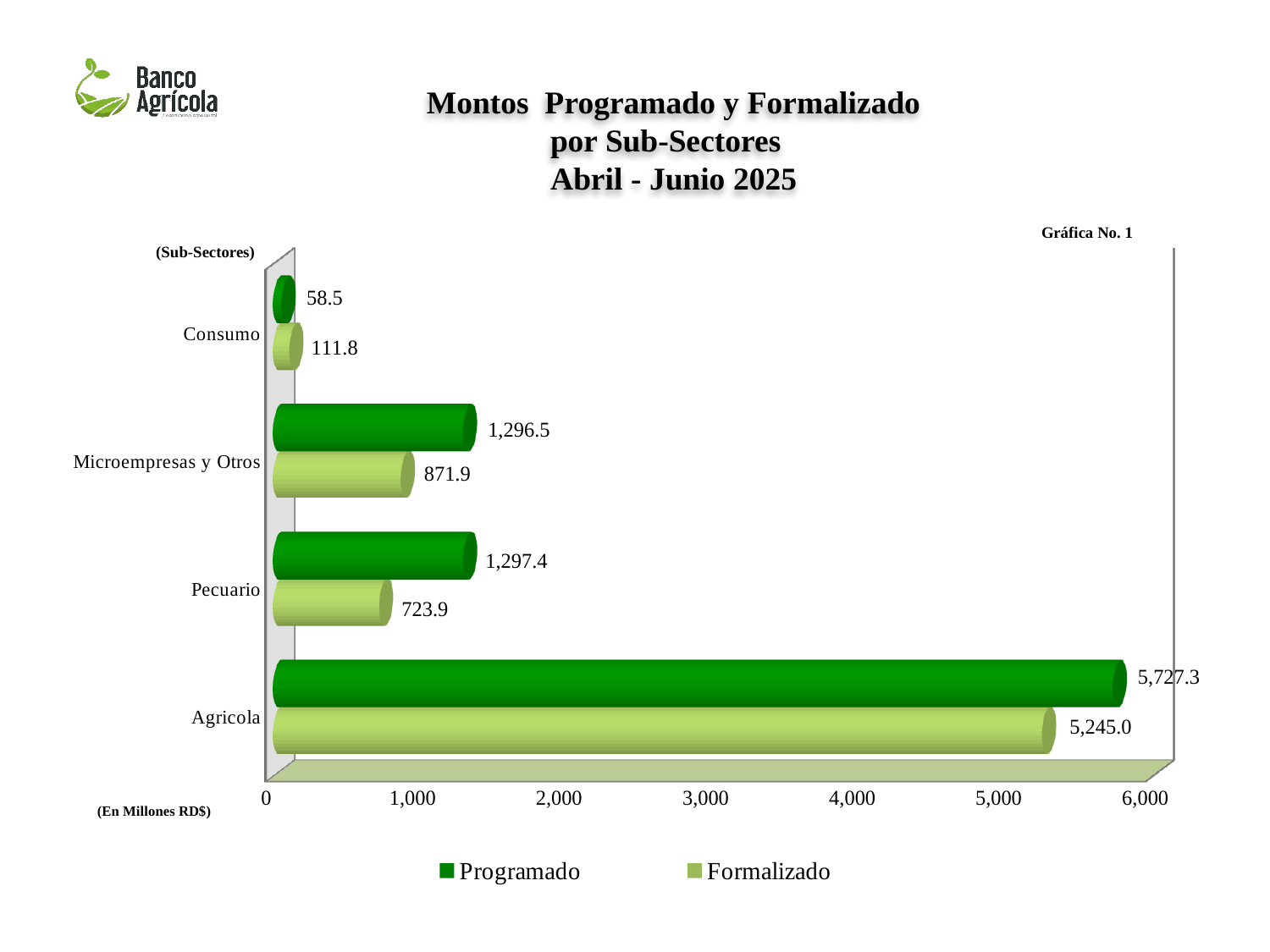
How many sub-sectors are shown on the chart? 4 Which sub-sector has the highest Programado value? Agricola What kind of chart is shown on the slide? Bar chart How many series does the legend list? 2 What is the Formalizado value for Consumo? 111.8 What is the difference between the Programado and Formalizado values for Pecuario? 573.5 Which sub-sector has the lowest Formalizado value? Consumo For Consumo, which is larger: the Programado value or the Formalizado value? Formalizado What is the Programado value for Agricola? 5,727.3 What is the Formalizado value for Pecuario? 723.9 What is the difference between the Programado and Formalizado values for Agricola? 482.3 What is the Programado value for Microempresas y Otros? 1,296.5